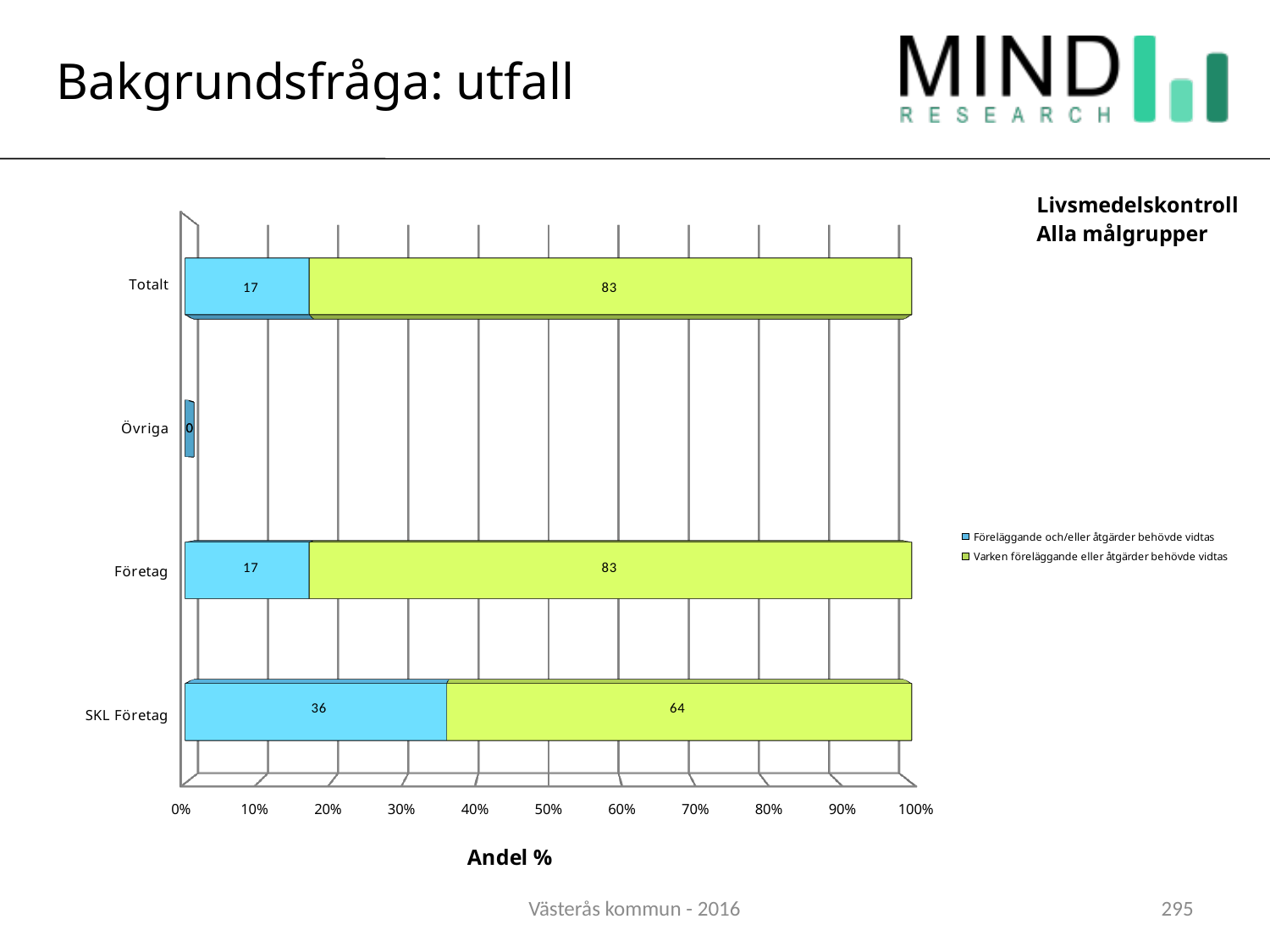
How many categories are shown on the vertical axis of the chart? 4 What is the value for 'Varken föreläggande eller åtgärder behövde vidtas' for SKL Företag? 64 Which category has the highest value for 'Föreläggande och/eller åtgärder behövde vidtas'? SKL Företag Which category has the lowest value for 'Föreläggande och/eller åtgärder behövde vidtas'? Övriga What is the value for 'Föreläggande och/eller åtgärder behövde vidtas' for Företag? 17 How many series does the legend list? 2 What is the difference between the 'Varken föreläggande eller åtgärder behövde vidtas' values for Företag and SKL Företag? 19 Which is larger for SKL Företag: 'Föreläggande och/eller åtgärder behövde vidtas' or 'Varken föreläggande eller åtgärder behövde vidtas'? Varken föreläggande eller åtgärder behövde vidtas What type of chart is shown on the slide? Stacked bar chart What is the value for 'Föreläggande och/eller åtgärder behövde vidtas' for SKL Företag? 36 What is the value for 'Varken föreläggande eller åtgärder behövde vidtas' for Totalt? 83 What is the label of the horizontal axis of the chart? Andel %